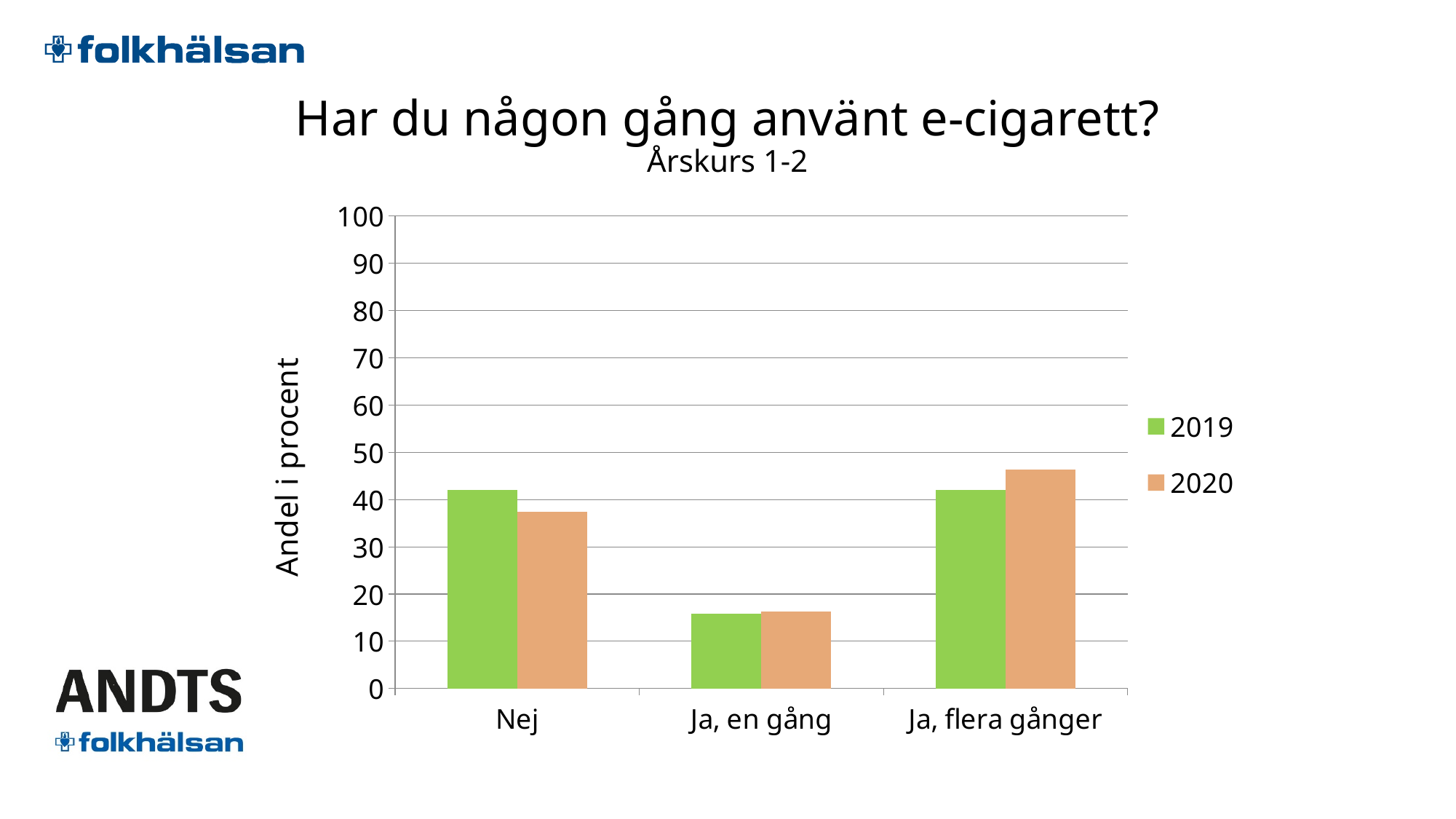
What is the label of the y axis? Andel i procent For the category Ja, flera gånger, which year has the larger value, 2019 or 2020? 2020 Is the value for Nej in 2020 greater or less than 40? less Is the value for Ja, flera gånger in 2020 greater or less than 50? less Which category has the lowest value for 2020? Ja, en gång Which category has the lowest value for 2019? Ja, en gång What kind of chart is shown on the slide? bar chart Is the value for Ja, en gång in 2019 greater or less than 20? less How many categories are shown on the x axis? 3 How many series does the legend list? 2 For the category Nej, which year has the larger value, 2019 or 2020? 2019 Which category has the highest value for 2020? Ja, flera gånger